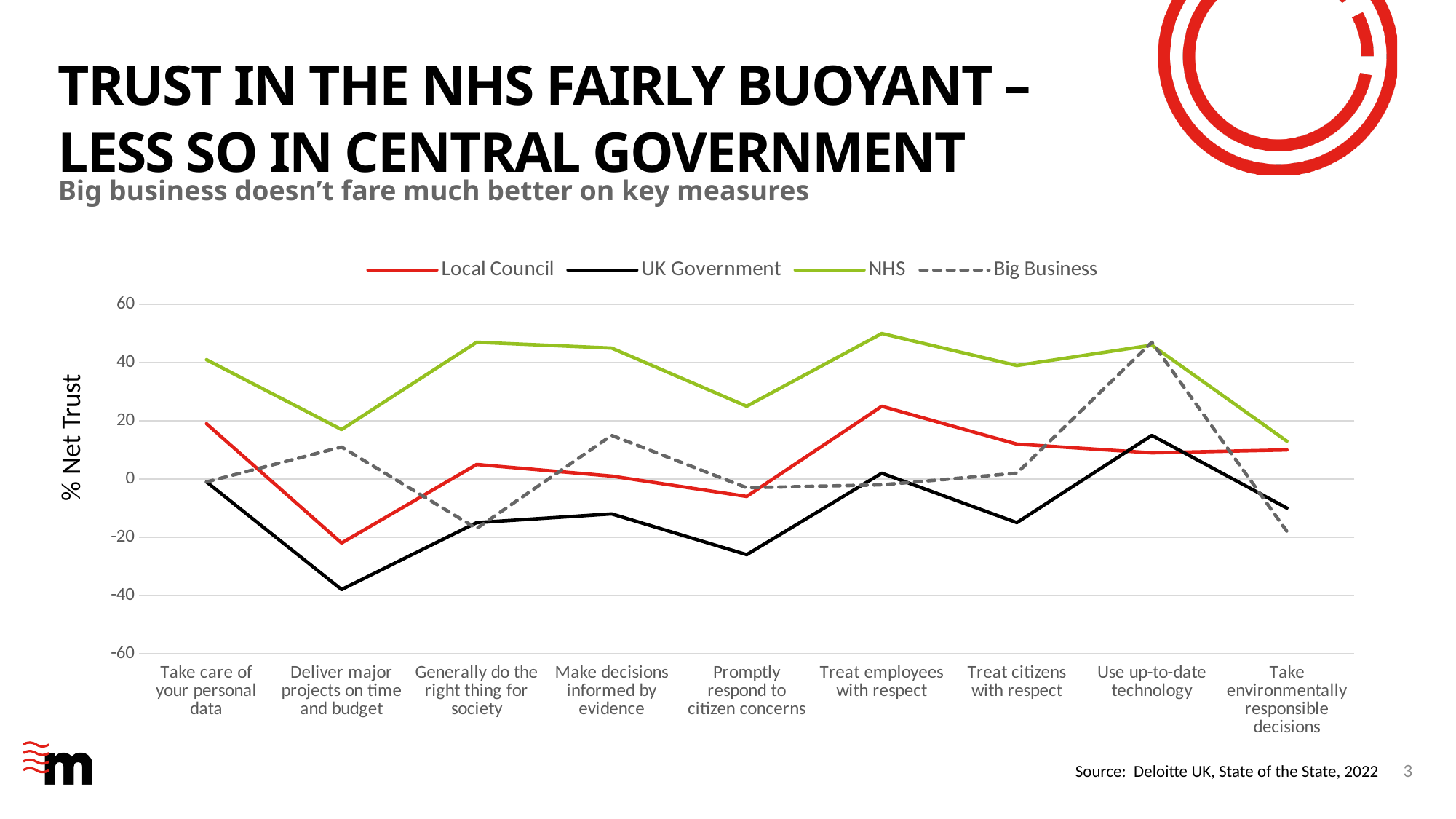
For 'Take care of your personal data', which is larger: the NHS value or the Local Council value? NHS How many series does the legend list? 4 For which category is the UK Government value lowest? Deliver major projects on time and budget Which series is drawn with a dashed line? Big Business Is the NHS value for 'Treat employees with respect' greater or less than 40? greater What kind of chart is shown on the slide? line chart Is the UK Government value for 'Deliver major projects on time and budget' greater or less than -20? less Does the UK Government line rise or fall from 'Deliver major projects on time and budget' to 'Make decisions informed by evidence'? rise For which category is the Local Council value highest? Treat employees with respect Is the Local Council value for 'Deliver major projects on time and budget' greater or less than 0? less How many categories are shown along the x axis? 9 For which category is the Big Business value highest? Use up-to-date technology